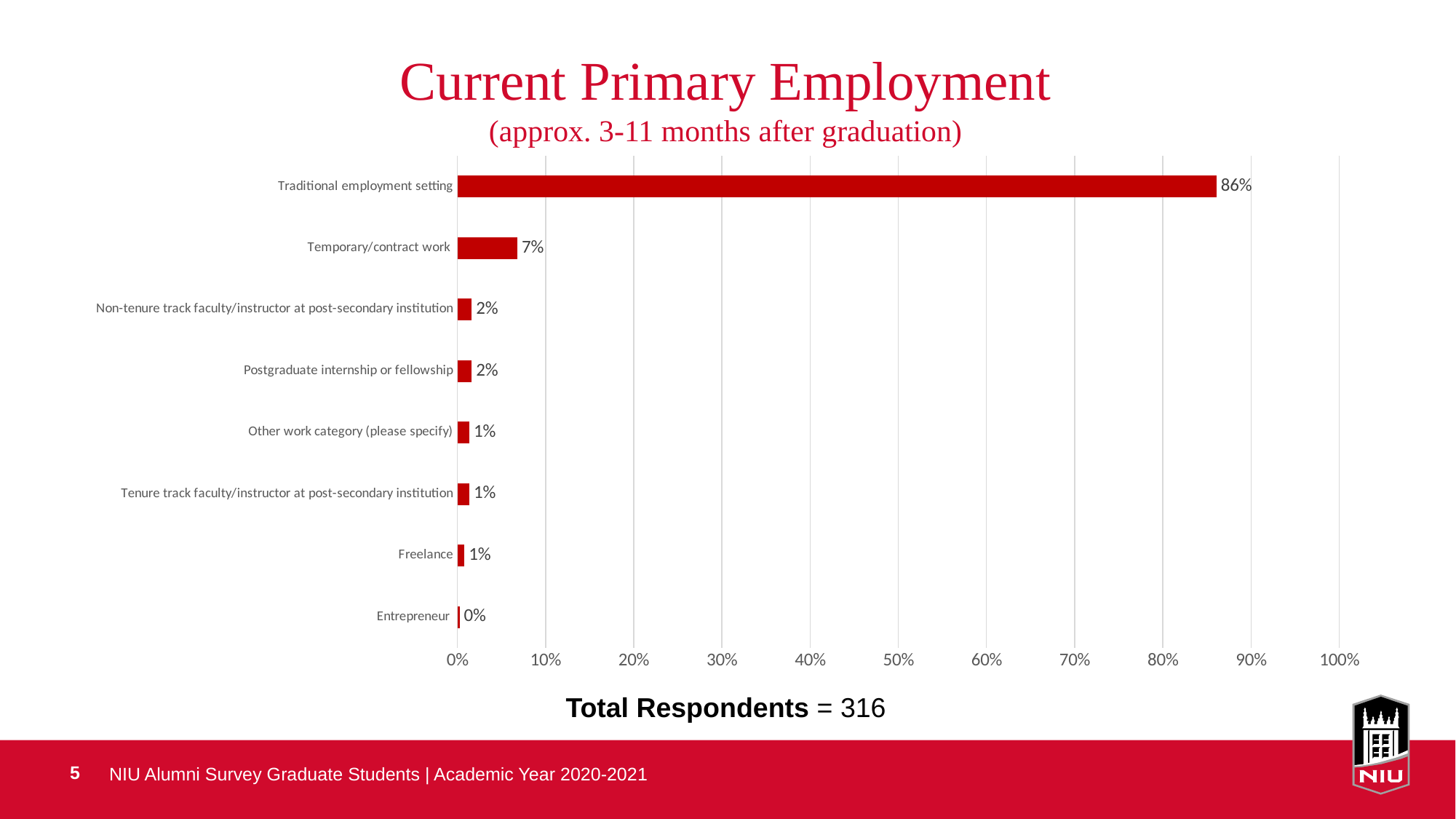
What type of chart is shown on the slide? Bar chart What percentage is shown for Postgraduate internship or fellowship? 2% How many employment categories are shown in the chart? 8 What is the difference in percentage points between Traditional employment setting and Temporary/contract work? 79 What is the value shown for Temporary/contract work? 7% Which employment category has the lowest percentage? Entrepreneur What percentage of respondents reported a traditional employment setting as their current primary employment? 86% What is the total number of respondents stated below the chart? 316 Which employment category has the highest percentage? Traditional employment setting Which is larger, the value for Temporary/contract work or the value for Non-tenure track faculty/instructor at post-secondary institution? Temporary/contract work Is the value for Traditional employment setting greater or less than 80%? greater What value is shown for Entrepreneur? 0%